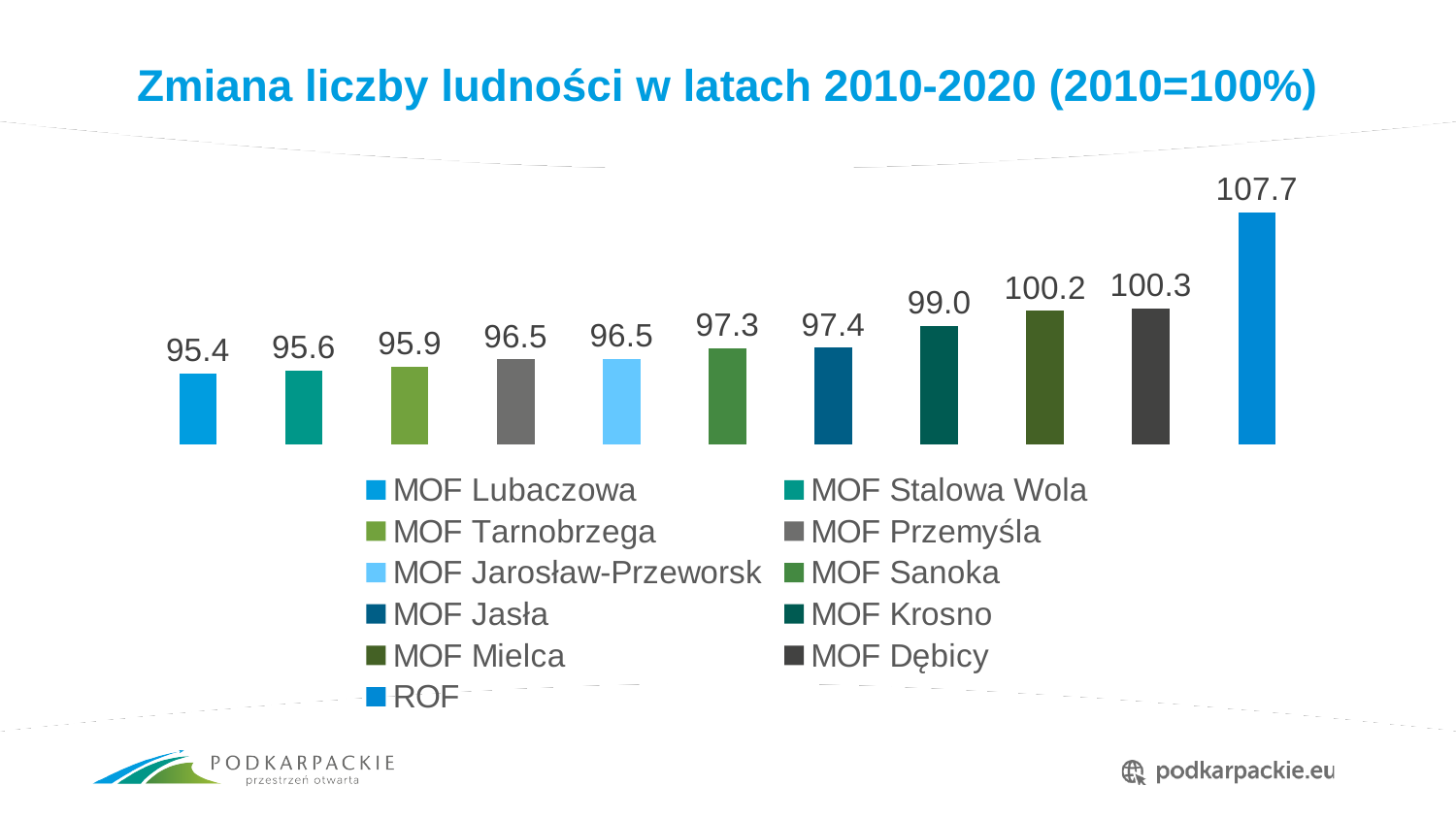
What is the title of the chart? Zmiana liczby ludności w latach 2010-2020 (2010=100%) Which is larger, the value for MOF Dębicy or the value for MOF Jasła? MOF Dębicy What is the value for MOF Krosno? 99.0 Which category has the highest value? ROF How many bars are shown in the chart? 11 What is the difference between the values for ROF and MOF Lubaczowa? 12.3 What kind of chart is shown on the slide? Bar chart What is the value for MOF Lubaczowa? 95.4 Which category has the lowest value? MOF Lubaczowa What is the difference between the values for MOF Krosno and MOF Sanoka? 1.7 What is the value for ROF? 107.7 What is the value for MOF Mielca? 100.2